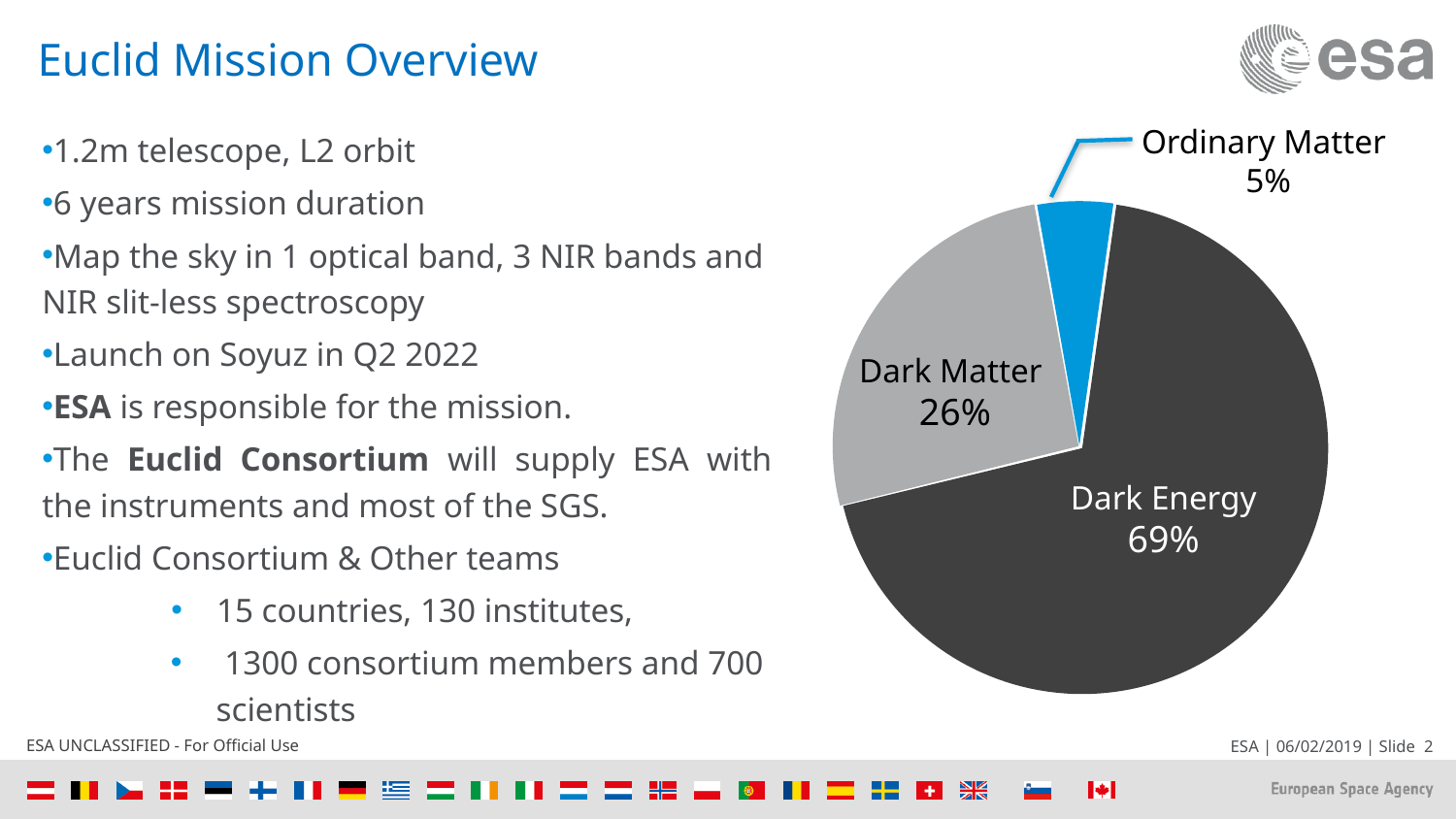
What is the difference in percentage points between Dark Matter and Ordinary Matter? 21 Which slice of the pie is the largest? Dark Energy What is the combined share of Dark Matter and Ordinary Matter? 31% How many slices does the pie chart have? 3 What is the difference in percentage points between Dark Energy and Dark Matter? 43 What share of the pie does Ordinary Matter represent? 5% What share of the pie does Dark Matter represent? 26% Which is larger, the Dark Matter slice or the Ordinary Matter slice? Dark Matter What share of the pie does Dark Energy represent? 69% What colour is the Ordinary Matter slice? blue What kind of chart is shown on the slide? pie chart Which slice of the pie is the smallest? Ordinary Matter